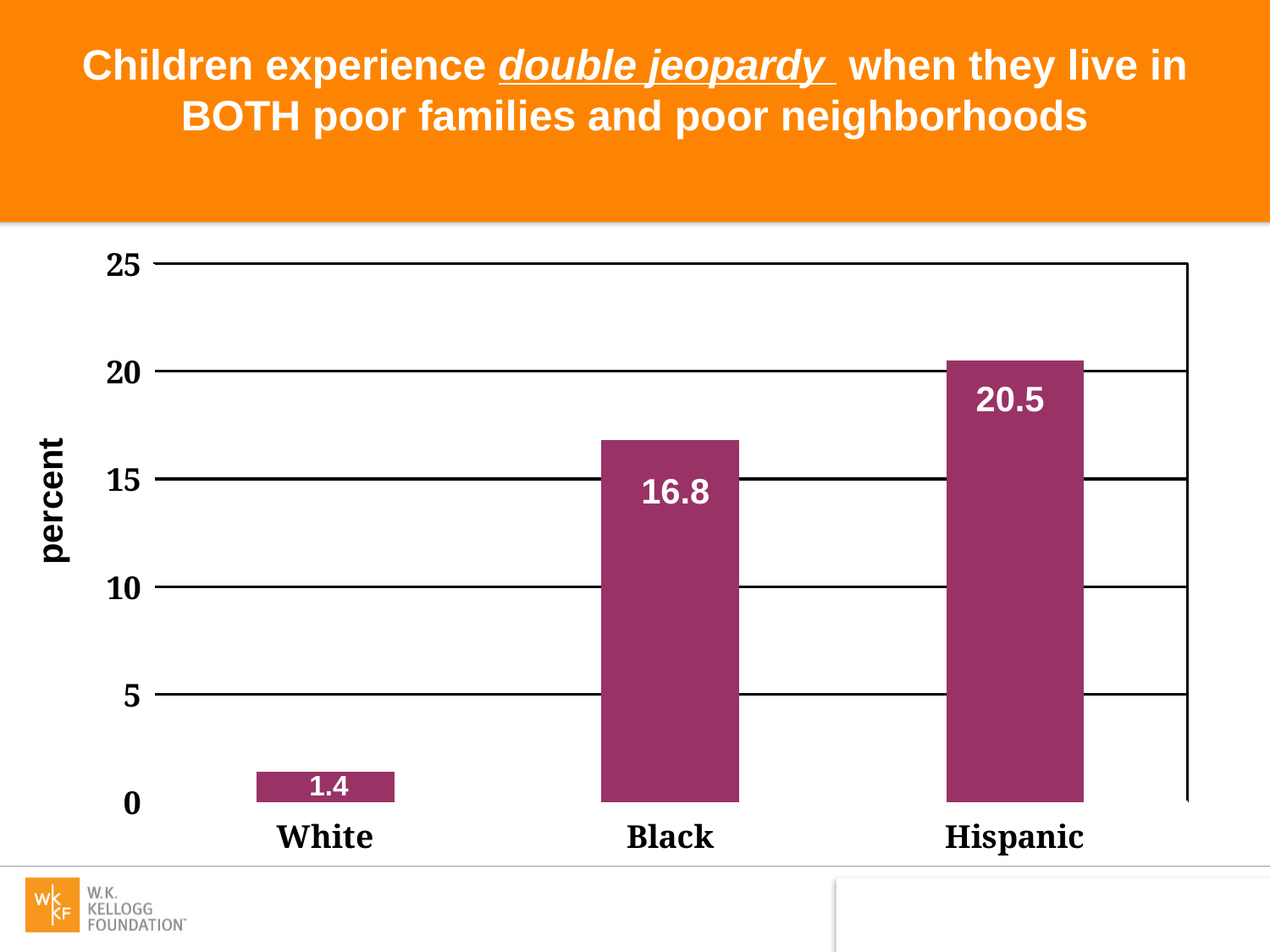
What is the value for Hispanic? 20.5 Which category has the highest value? Hispanic Which is larger, the value for Black or the value for Hispanic? Hispanic What is the difference between the values for Hispanic and Black? 3.7 Is the value for Black greater or less than 15? greater What is the value for Black? 16.8 How many categories are shown on the x axis? 3 What is the difference between the values for Black and White? 15.4 What kind of chart is shown on the slide? bar chart What is the value for White? 1.4 What is the label on the vertical axis? percent Which category has the lowest value? White